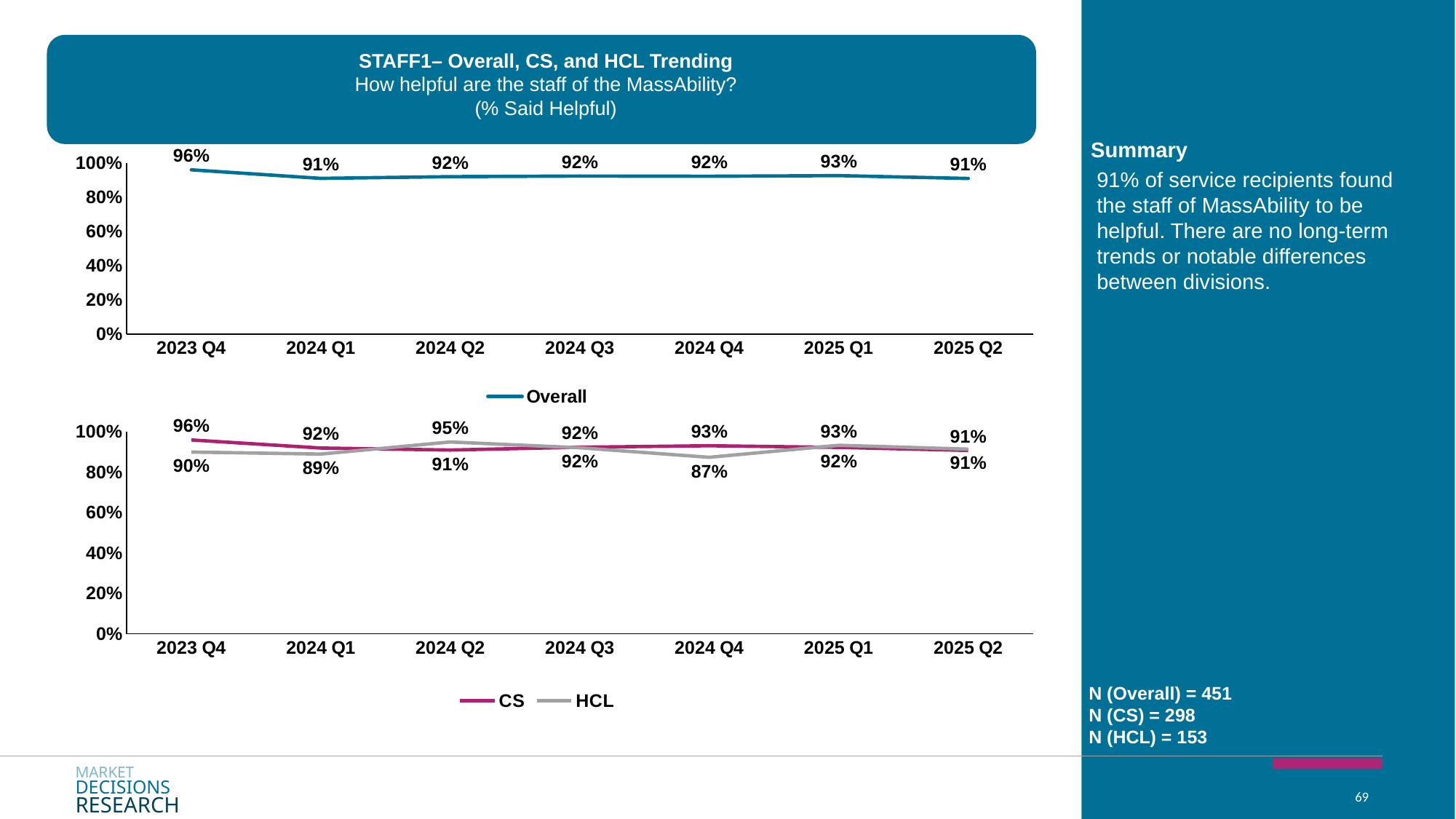
In the bottom chart, how many series does the legend list? 2 In the bottom chart, what is the CS value for 2024 Q2? 91% In the bottom chart, which quarter has the lowest HCL value? 2024 Q4 In the bottom chart, which is larger at 2024 Q2, CS or HCL? HCL In the bottom chart, what is the HCL value for 2024 Q4? 87% In the top chart (Overall), what is the difference between the 2023 Q4 value and the 2024 Q1 value? 5% What kind of chart is the top chart? Line chart In the top chart (Overall), which quarter has the highest value? 2023 Q4 In the bottom chart, what is the difference between the CS and HCL values at 2024 Q4? 6% In the top chart (Overall), how many quarters are plotted? 7 In the top chart (Overall), what is the value for 2025 Q2? 91% In the top chart (Overall), what is the value for 2023 Q4? 96%